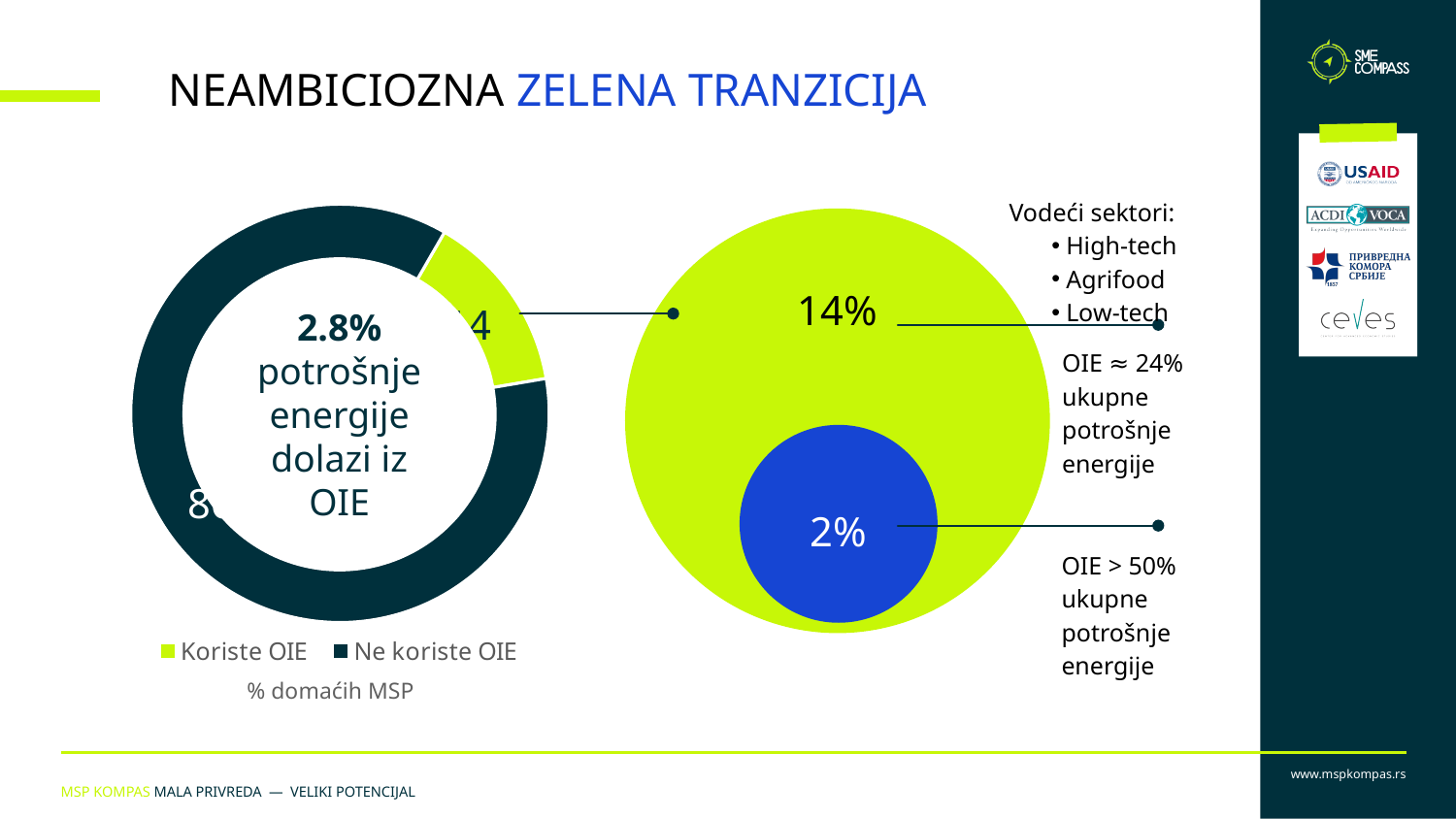
How many categories does the legend of the doughnut chart list? 2 Which slice of the doughnut chart is the smallest? Koriste OIE What type of chart is shown on the left of the slide? Doughnut (pie) chart In the circle graphic on the right, what value is shown in the blue circle? 2% In the circle graphic on the right, what value is shown in the large green circle? 14% How many slices does the doughnut chart have? 2 Which slice of the doughnut chart is the largest? Ne koriste OIE What text is written in the centre of the doughnut chart? 2.8% potrošnje energije dolazi iz OIE In the circle graphic on the right, which circle shows the larger value: the green one or the blue one? The green one (14%) What are the two legend entries of the doughnut chart? Koriste OIE and Ne koriste OIE In the circle graphic on the right, what is the difference between the green circle value and the blue circle value? 12% In the doughnut chart, which is larger: Koriste OIE or Ne koriste OIE? Ne koriste OIE